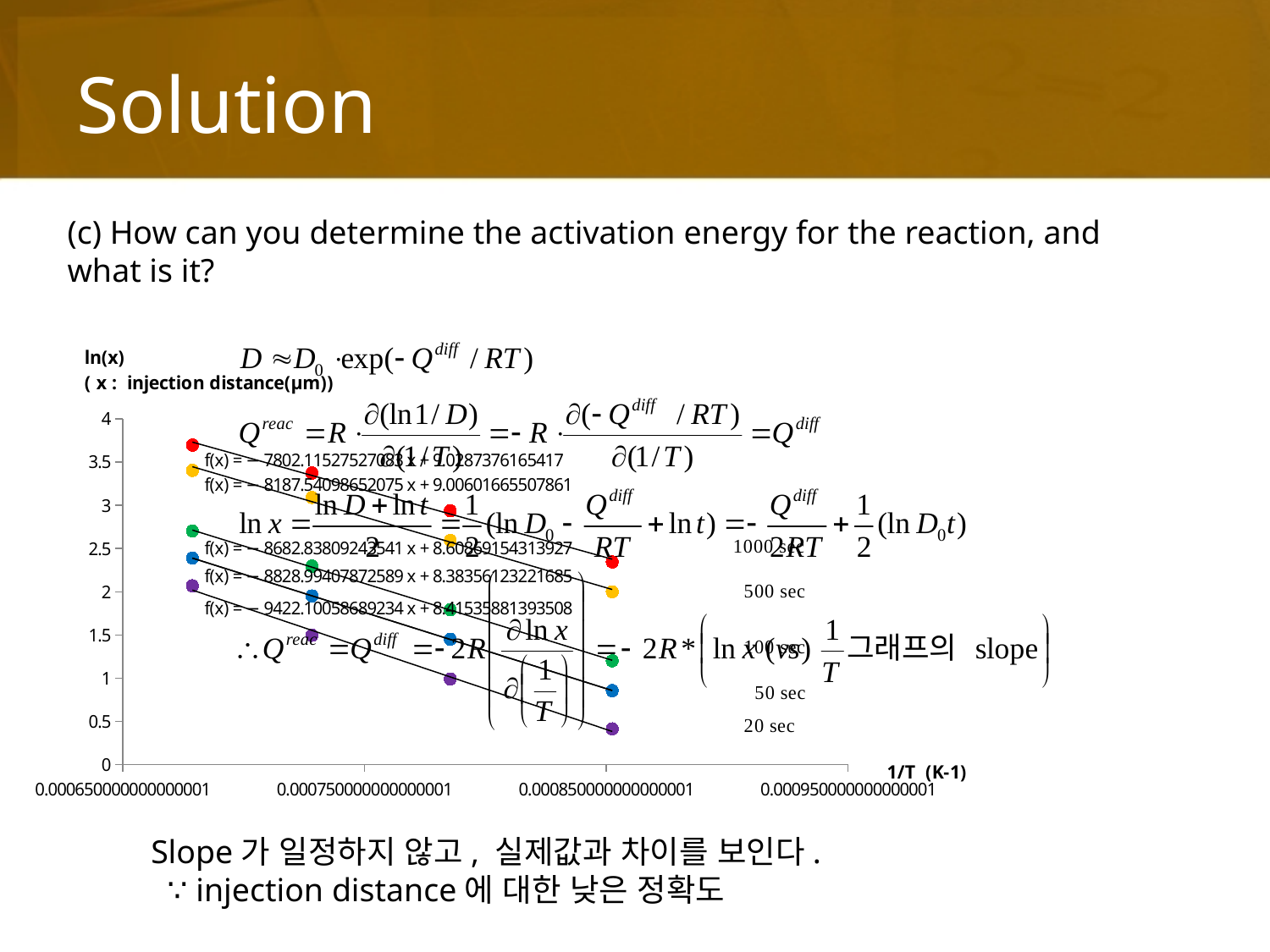
What is the label of the x axis of the chart? 1/T (K-1) Do the ln(x) values rise or fall as 1/T increases along the x axis? fall Which series has the highest ln(x) values on the chart? 1000 sec How many data series (time labels such as 1000 sec, 500 sec) are plotted on the chart? 5 What kind of chart is shown on the slide? scatter chart Is the ln(x) value of the 500 sec series at its rightmost point greater or less than 2.5? less Is the ln(x) value of the 100 sec series at its leftmost point greater or less than 2.5? greater At the largest 1/T value, which series has the higher ln(x): 1000 sec or 20 sec? 1000 sec Is the ln(x) value of the 20 sec series at its rightmost point (largest 1/T) greater or less than 0.5? less How many data points does each series on the chart have? 4 Which series has the lowest ln(x) values on the chart? 20 sec